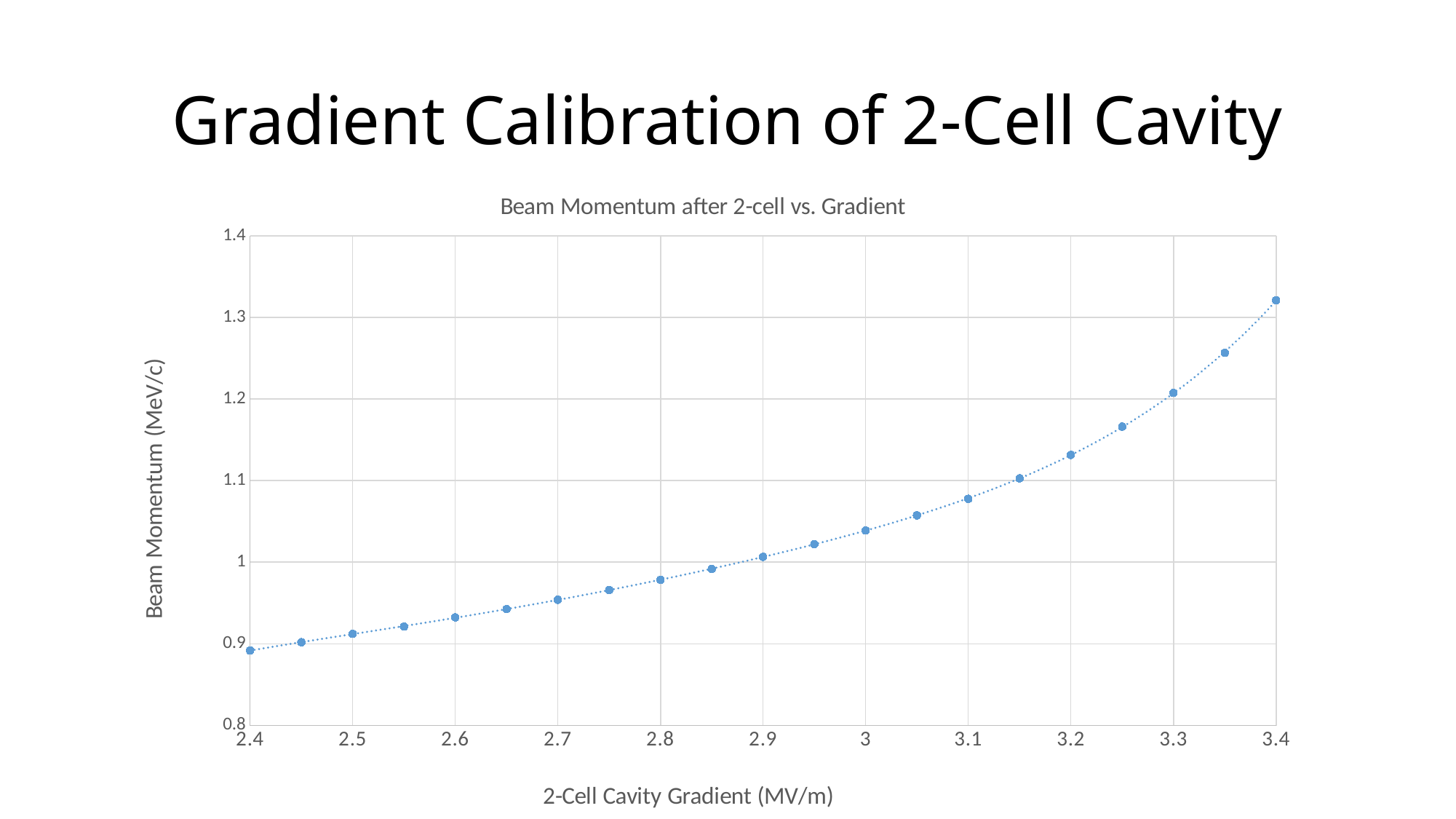
At which gradient value is the beam momentum lowest? 2.4 Is the beam momentum at a gradient of 3.1 greater or less than 1.1? less What is the label of the y axis? Beam Momentum (MeV/c) Is the beam momentum at a gradient of 2.4 greater or less than 0.9? less Is the beam momentum at a gradient of 2.8 greater or less than 1? less At which gradient value is the beam momentum highest? 3.4 What is the title of the chart? Beam Momentum after 2-cell vs. Gradient What kind of chart is shown on the slide? Scatter plot with a dotted line Which has the larger beam momentum: a gradient of 2.6 or a gradient of 3.2? 3.2 Do the beam momentum values rise or fall as the gradient increases along the x axis? Rise How many data points are plotted on the chart? 21